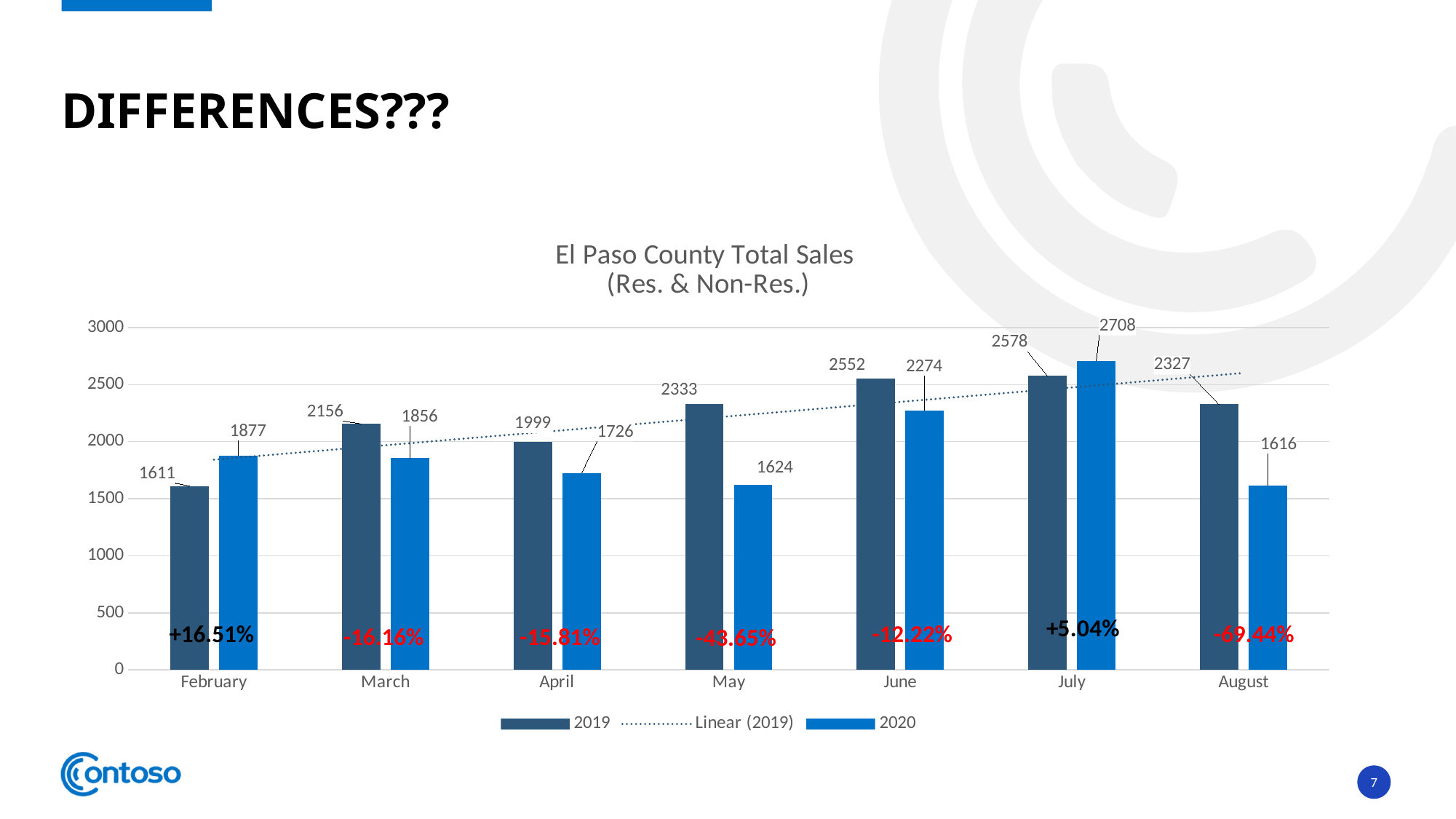
Which month has the lowest 2019 value? February What is the 2020 value for April? 1726 What is the difference between the 2019 and 2020 values for May? 709 What kind of chart is this? bar chart What is the title of the chart? El Paso County Total Sales (Res. & Non-Res.) Which is larger for February, the 2019 value or the 2020 value? 2020 Is the 2020 value for August greater or less than 2000? less What is the 2019 value for May? 2333 How many entries does the legend list? 3 Which month has the highest 2020 value? July How many months are shown on the x axis? 7 What is the difference between the 2020 and 2019 values for July? 130